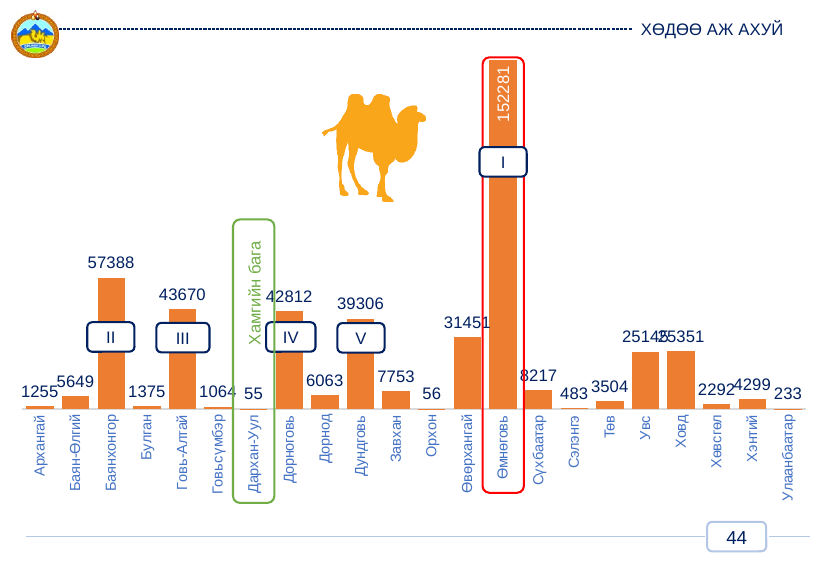
What value is shown for Дундговь? 39306 What value is shown for Баянхонгор? 57388 Which category has the highest value? Өмнөговь What kind of chart is this? Bar chart Which is larger, the value for Өвөрхангай or the value for Сүхбаатар? Өвөрхангай Which category has the lowest value? Дархан-Уул What is the difference between the values for Дорноговь and Дундговь? 3506 What is the difference between the values for Баянхонгор and Говь-Алтай? 13718 How many categories are shown on the x axis? 22 What value is shown for Дархан-Уул? 55 Which category is marked with the rank label "III"? Говь-Алтай What value is shown for Өмнөговь? 152281